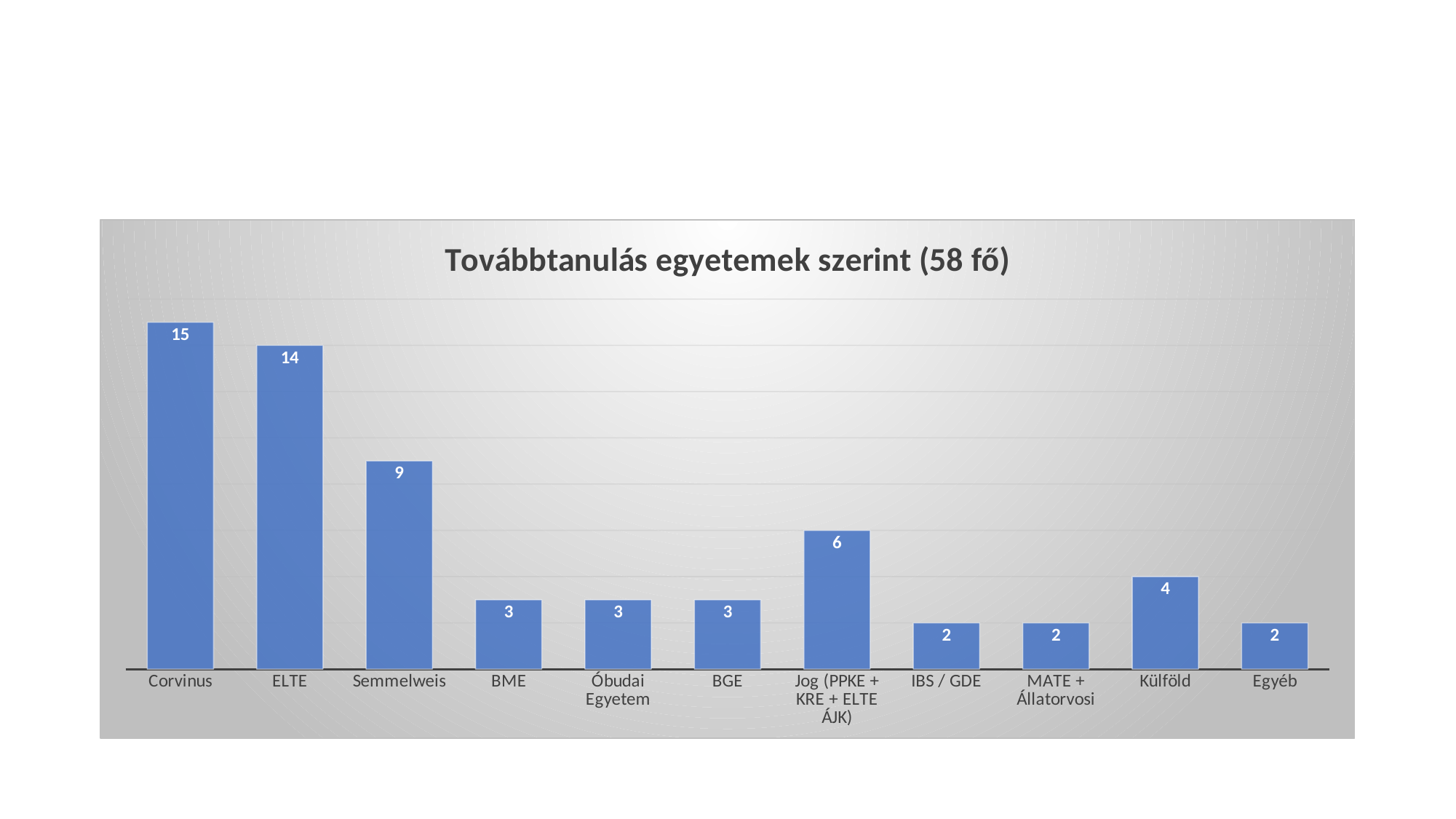
How many categories are shown on the x axis? 11 What is the value for Jog (PPKE + KRE + ELTE ÁJK)? 6 What is the value for Corvinus? 15 What is the difference between the values for Semmelweis and BME? 6 What is the value for Egyéb? 2 Which category has the highest value? Corvinus What is the title of the chart? Továbbtanulás egyetemek szerint (58 fő) Which is larger, the value for Külföld or the value for IBS / GDE? Külföld What is the difference between the values for Corvinus and ELTE? 1 What kind of chart is this? bar chart What is the value for Külföld? 4 What is the value for Semmelweis? 9